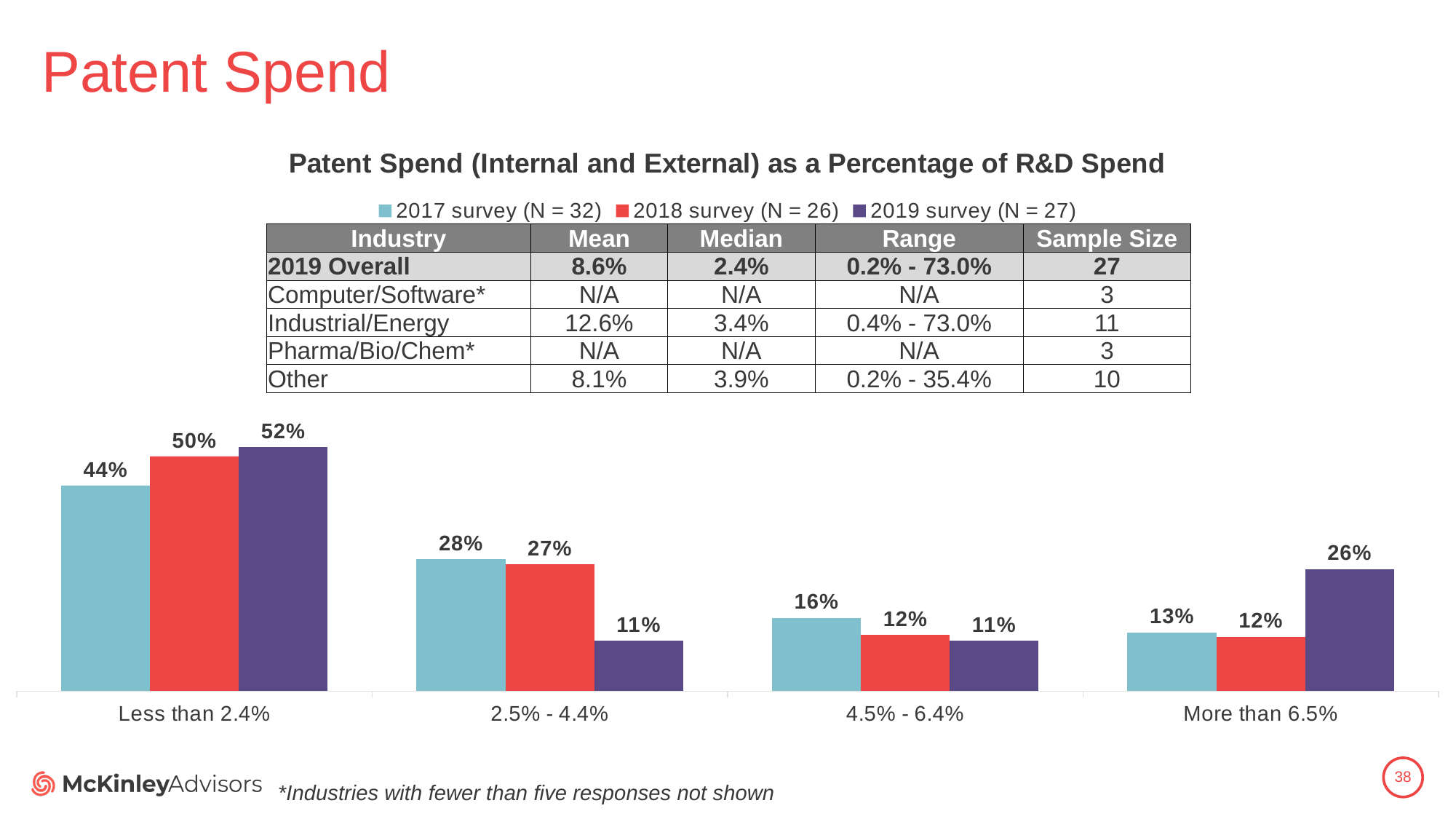
In the 'More than 6.5%' category, which is larger: the 2019 survey value or the 2017 survey value? 2019 survey Which category has the lowest value for the 2017 survey? More than 6.5% How many series does the chart legend list? 3 What is the difference between the 2019 survey and 2017 survey values in the 'Less than 2.4%' category? 8% Do the 2017 survey values rise or fall from 'Less than 2.4%' to 'More than 6.5%'? Fall What is the value for the 2018 survey in the 'More than 6.5%' category? 12% What is the value for the 2017 survey in the '4.5% - 6.4%' category? 16% What is the value for the 2019 survey in the 'Less than 2.4%' category? 52% What kind of chart is shown on the slide? Bar chart Which category has the highest value for the 2019 survey? Less than 2.4% What is the sample size (N) for the 2018 survey shown in the legend? 26 How many categories are shown on the x axis of the chart? 4